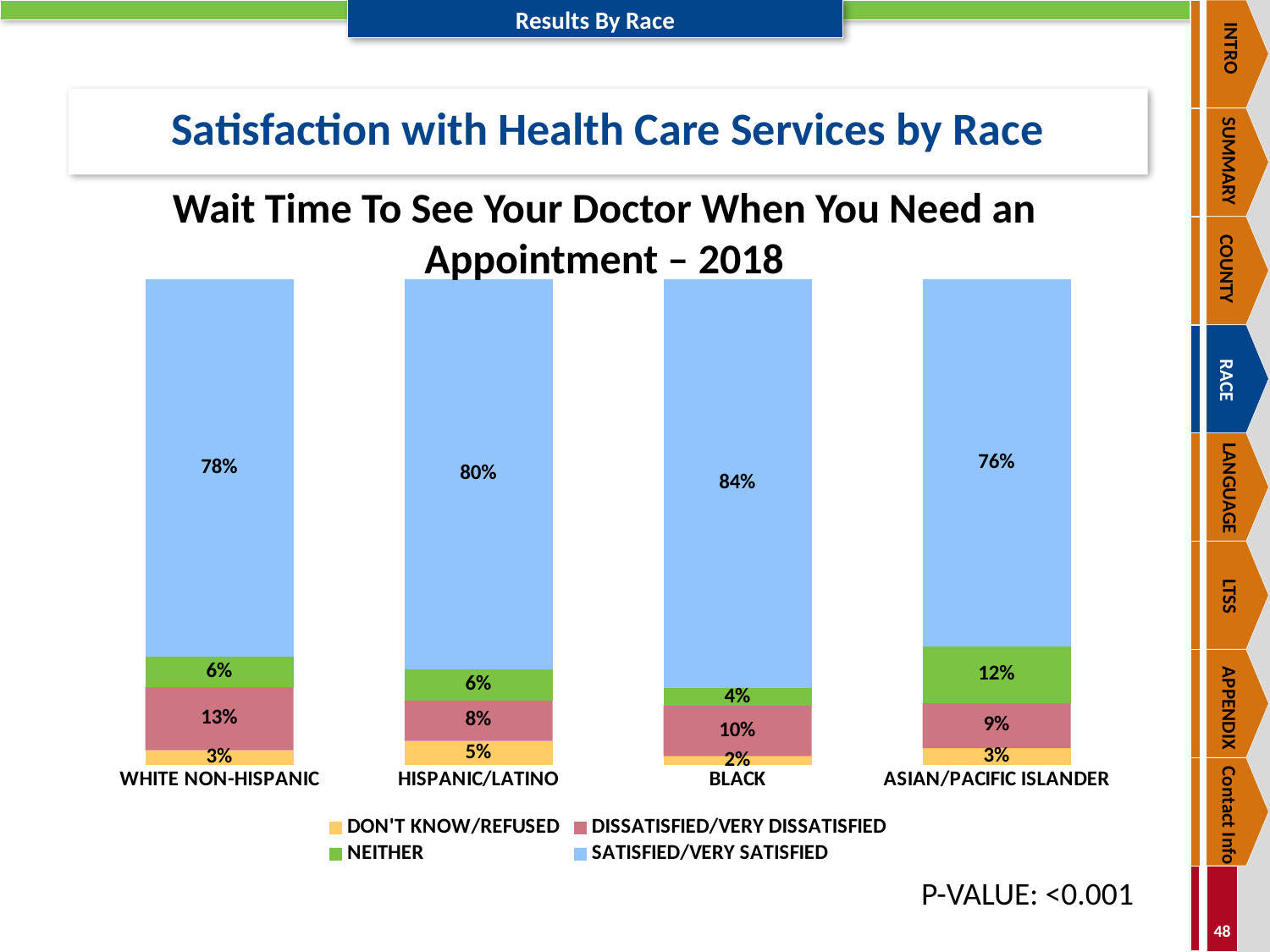
What is the difference between the Satisfied/Very Satisfied percentages for Black and Asian/Pacific Islander respondents? 8% What type of chart is used on this slide? Stacked bar chart What p-value is reported below the chart? <0.001 What is the Neither value for Asian/Pacific Islander respondents? 12% What percentage of Black respondents were Satisfied/Very Satisfied with wait time to see their doctor? 84% How many series does the chart legend list? 4 What percentage of White Non-Hispanic respondents were Dissatisfied/Very Dissatisfied? 13% Which group has a larger Dissatisfied/Very Dissatisfied percentage, White Non-Hispanic or Hispanic/Latino? White Non-Hispanic What is the Don't Know/Refused value for Hispanic/Latino respondents? 5% Which race group has the highest Satisfied/Very Satisfied percentage? Black Which race group has the lowest Satisfied/Very Satisfied percentage? Asian/Pacific Islander How many race groups are shown on the x axis of the chart? 4